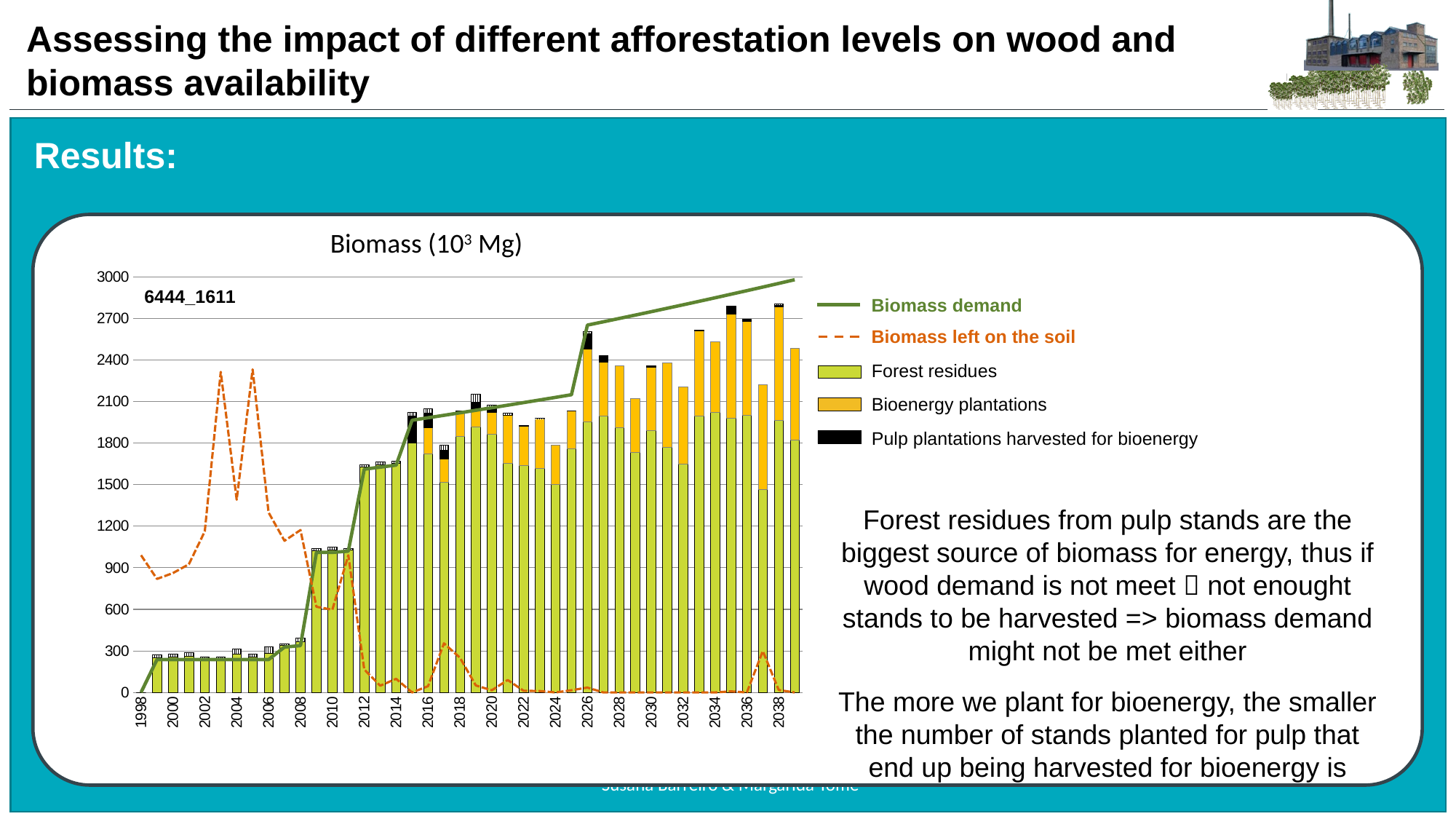
Is the Biomass demand value in 2010 greater or less than 900? greater Which is larger, Biomass demand in 2038 or Biomass demand in 2000? Biomass demand in 2038 Is the Biomass demand value in 2038 greater or less than 2700? greater Is the Biomass left on the soil value in 2030 greater or less than 300? less Which legend entry is drawn as an orange dashed line? Biomass left on the soil How many tick labels are shown on the y axis? 11 How many series does the chart legend list? 5 What kind of chart is shown on the slide? A stacked bar chart combined with line series Does Biomass demand rise or fall from 1998 to 2038? rise What is the title of the chart? Biomass (10³ Mg)